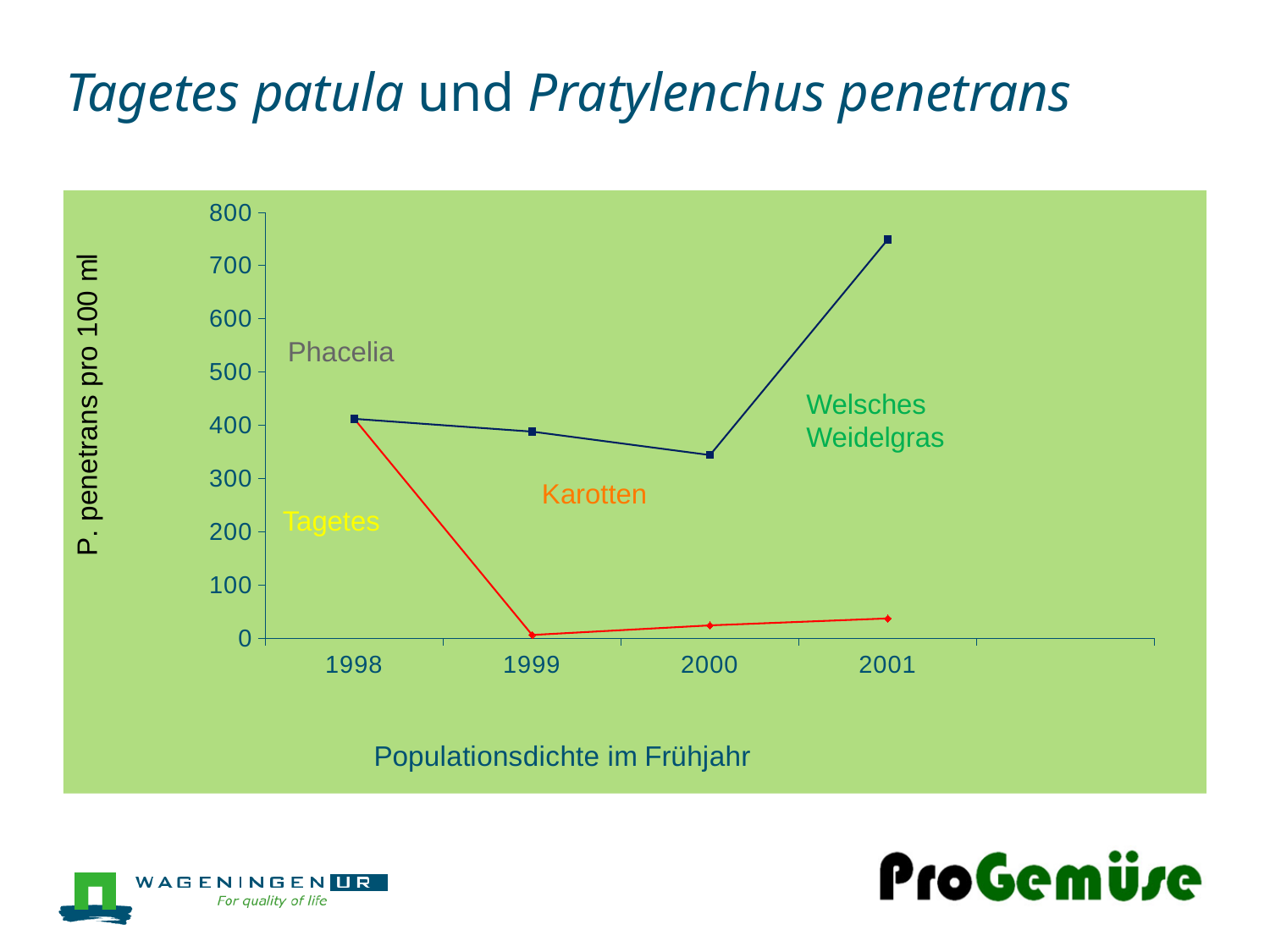
Is the value of the red line in 1999 greater or less than 100? less In which year does the dark blue line reach its highest value? 2001 Is the value of the dark blue line in 2000 greater or less than 300? greater How many years are labelled on the x axis of the chart? 4 How many lines are plotted in the chart? 2 In which year does the red line reach its lowest value? 1999 Does the red line rise or fall between 1998 and 1999? fall Is the value of the red line in 2001 greater or less than 100? less In 2001, which line has the larger value, the dark blue line or the red line? the dark blue line What kind of chart is shown on the slide? line chart What is the title of the y axis of the chart? P. penetrans pro 100 ml